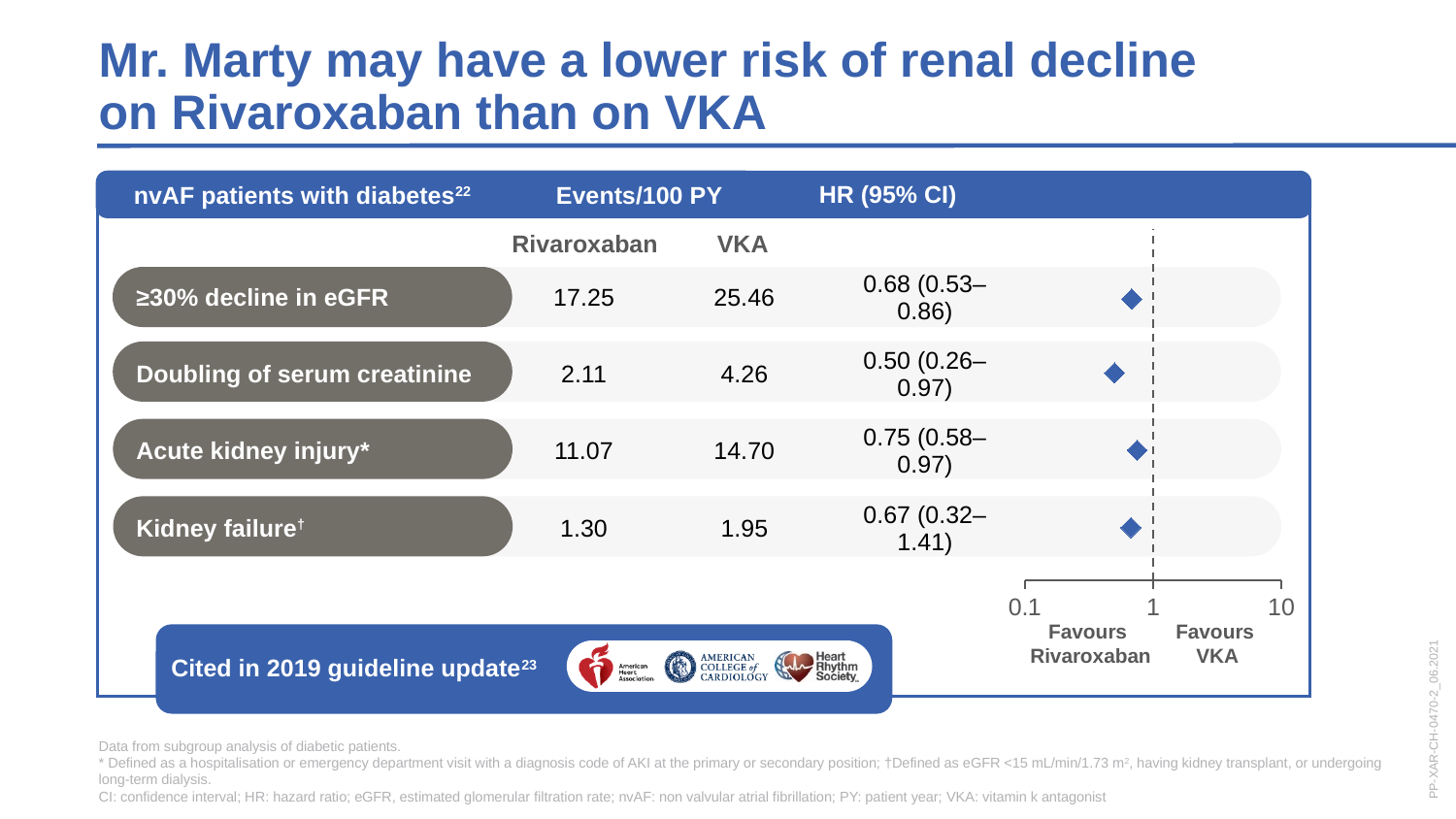
What kind of chart is shown on the right of the table? Forest plot What is the difference in events/100 PY between VKA and Rivaroxaban for ≥30% decline in eGFR? 8.21 For acute kidney injury, which has more events/100 PY, Rivaroxaban or VKA? VKA What is the difference in events/100 PY between VKA and Rivaroxaban for kidney failure? 0.65 Which outcome has the lowest hazard ratio point estimate? Doubling of serum creatinine What is the VKA events/100 PY value for acute kidney injury? 14.70 How many outcomes are plotted in the forest plot? 4 Which treatment does the left side of the forest plot axis favour? Rivaroxaban Which outcome has the highest hazard ratio point estimate? Acute kidney injury Is the hazard ratio point for kidney failure plotted greater or less than 1? less What is the Rivaroxaban events/100 PY value for doubling of serum creatinine? 2.11 What is the HR (95% CI) for ≥30% decline in eGFR? 0.68 (0.53–0.86)